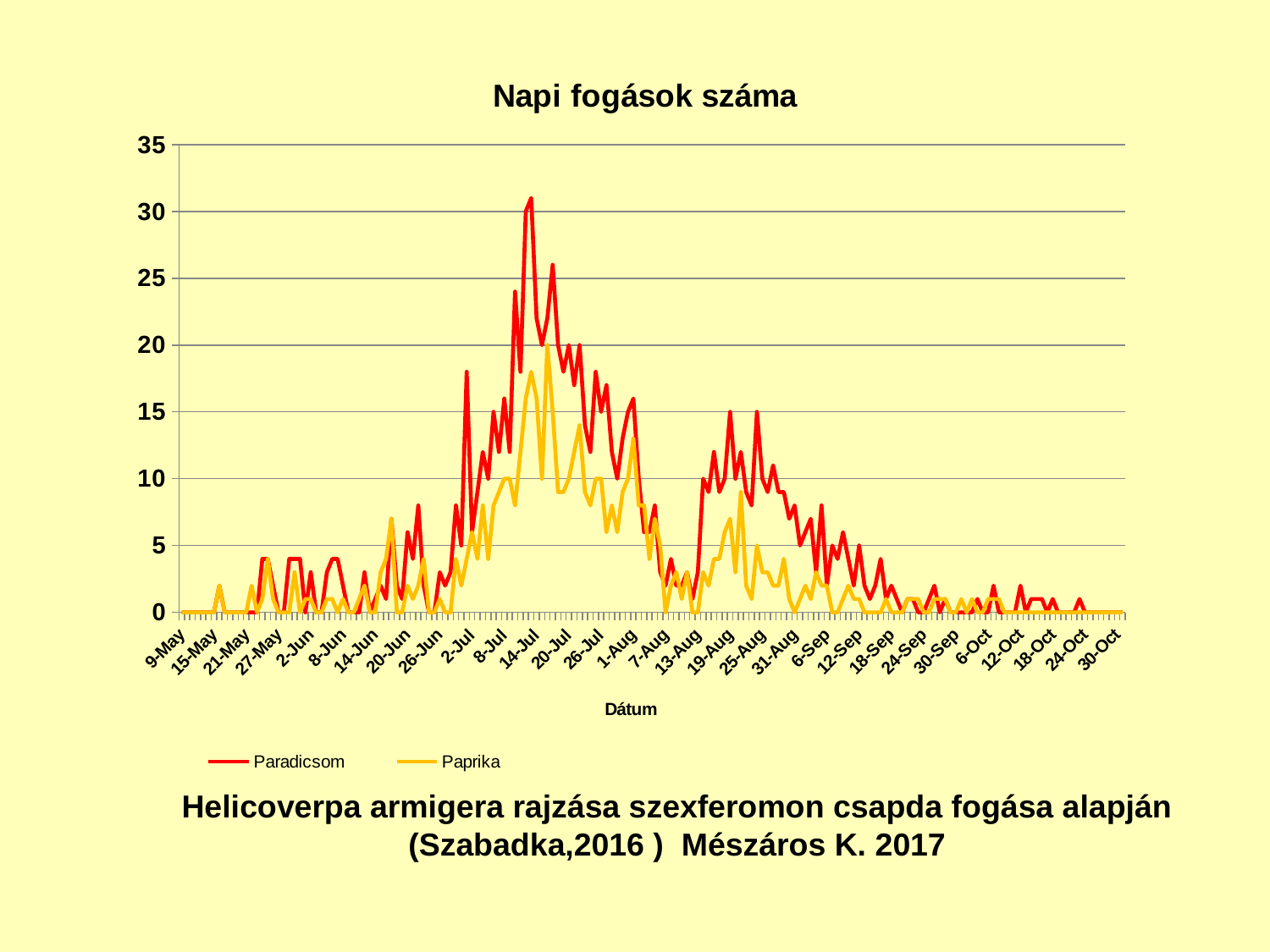
Do the values of the Paradicsom series generally rise or fall from 9-May to mid-July? rise Is the peak value of the Paprika series greater or less than 25? less Around 14-Jul, which series has the higher value, Paradicsom or Paprika? Paradicsom What is the title of the chart? Napi fogások száma Is the peak value of the Paradicsom series greater or less than 25? greater Which series reaches the highest peak value in the chart? Paradicsom How many series does the legend list? 2 What kind of chart is shown on the slide? line chart What is the label of the x axis? Dátum Is the peak value of the Paprika series greater or less than 15? greater Do the values of the Paradicsom series generally rise or fall from mid-July to the end of October? fall